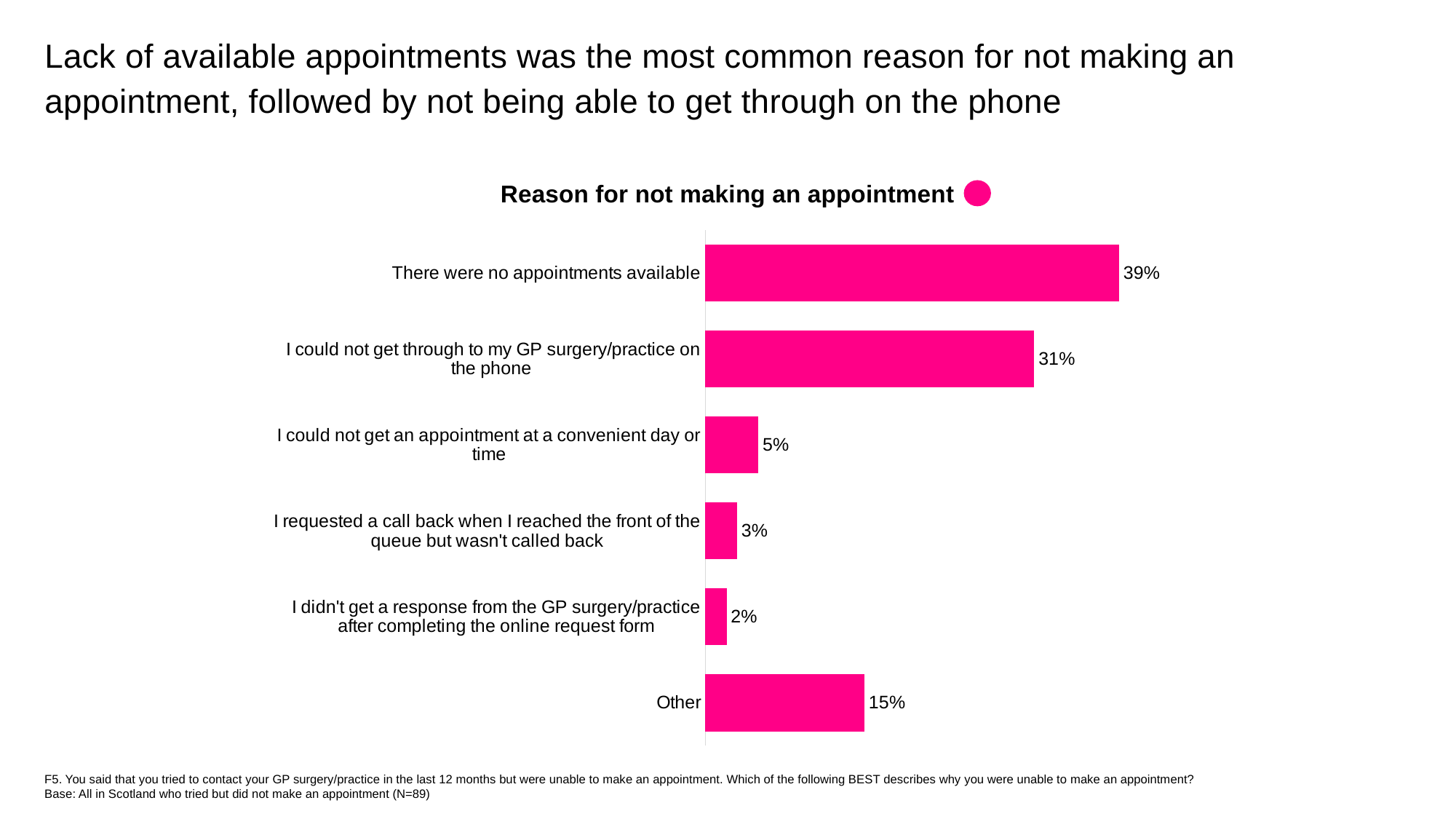
What is the value for 'I didn't get a response from the GP surgery/practice after completing the online request form'? 2% What is the title of the chart? Reason for not making an appointment What is the difference in percentage points between 'There were no appointments available' and 'I could not get through to my GP surgery/practice on the phone'? 8 percentage points What percentage of respondents said there were no appointments available? 39% What is the value for 'I could not get through to my GP surgery/practice on the phone'? 31% How many reasons (categories) are shown in the chart? 6 What kind of chart is shown on the slide? Bar chart What percentage is shown for 'Other'? 15% Which reason has the highest percentage? There were no appointments available Which reason has the lowest percentage? I didn't get a response from the GP surgery/practice after completing the online request form Which is larger: the value for 'Other' or the value for 'I could not get an appointment at a convenient day or time'? Other What is the base size (N) stated for the chart? N=89